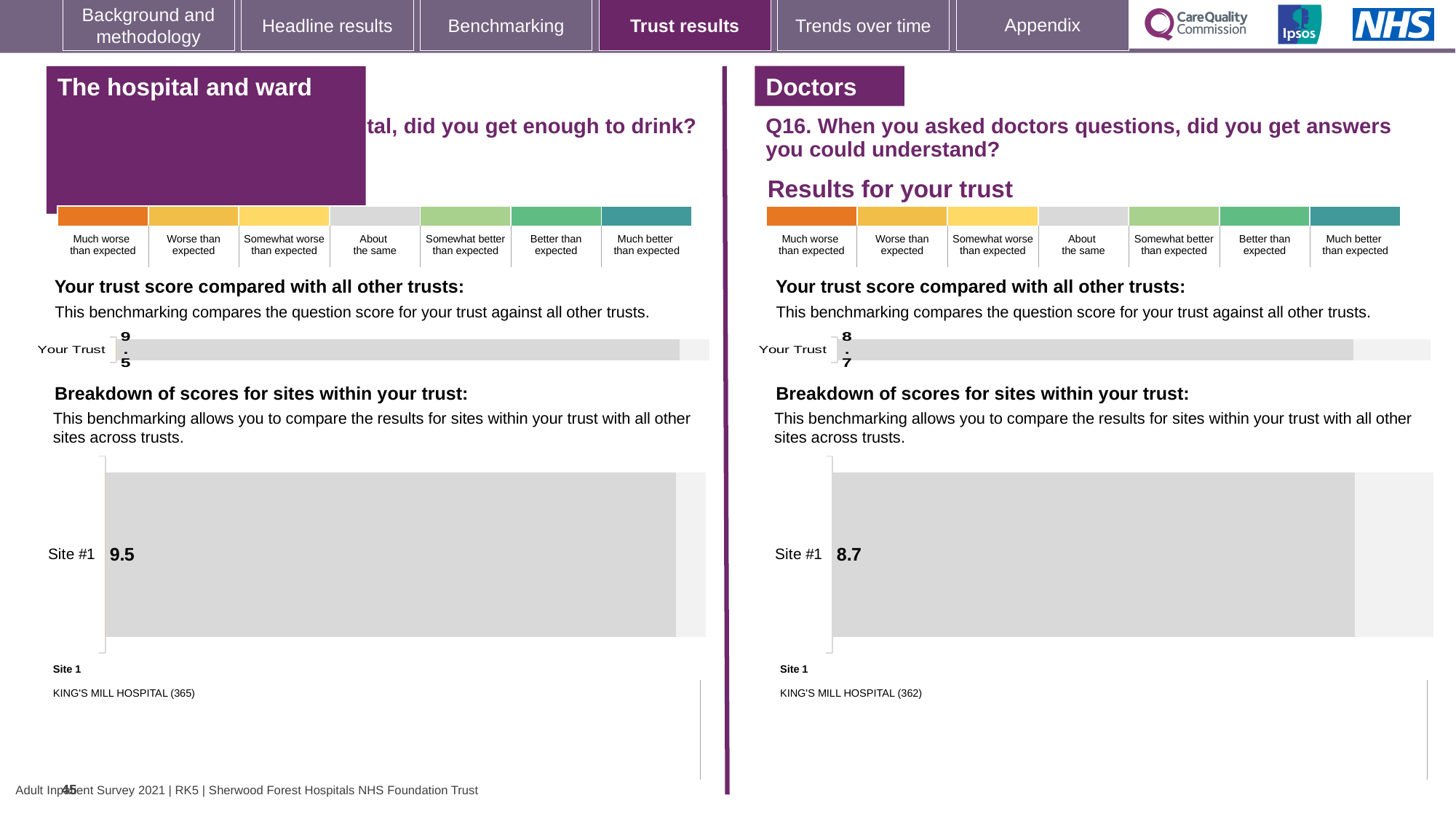
How many sites are plotted on the right-hand 'Breakdown of scores for sites within your trust' chart (Doctors, Q16)? 1 On the left-hand 'Breakdown of scores for sites within your trust' chart, what is the score for Site #1? 9.5 On the right-hand 'Breakdown of scores for sites within your trust' chart (Doctors, Q16), what is the score for Site #1? 8.7 Which is higher: the Site #1 score on the left-hand site breakdown chart or the Site #1 score on the right-hand site breakdown chart? The left-hand chart (9.5) Which is higher: the Your Trust score on the left-hand chart (The hospital and ward) or the Your Trust score on the right-hand chart (Doctors, Q16)? The left-hand chart (The hospital and ward) On the right-hand 'Your trust score compared with all other trusts' chart (Doctors, Q16), what is the score shown for Your Trust? 8.7 On the left-hand 'Your trust score compared with all other trusts' chart (The hospital and ward section), what is the score shown for Your Trust? 9.5 On the left-hand side of the slide, which hospital is listed as Site 1 below the site breakdown chart? KING'S MILL HOSPITAL (365) On the right-hand side of the slide (Doctors, Q16), which hospital is listed as Site 1 below the site breakdown chart? KING'S MILL HOSPITAL (362) What type of chart is used for the 'Breakdown of scores for sites within your trust' on the right-hand side of the slide? Bar chart What is the difference between the Your Trust score on the left-hand chart (9.5) and the Your Trust score on the right-hand chart (8.7)? 0.8 How many sites are plotted on the left-hand 'Breakdown of scores for sites within your trust' chart? 1